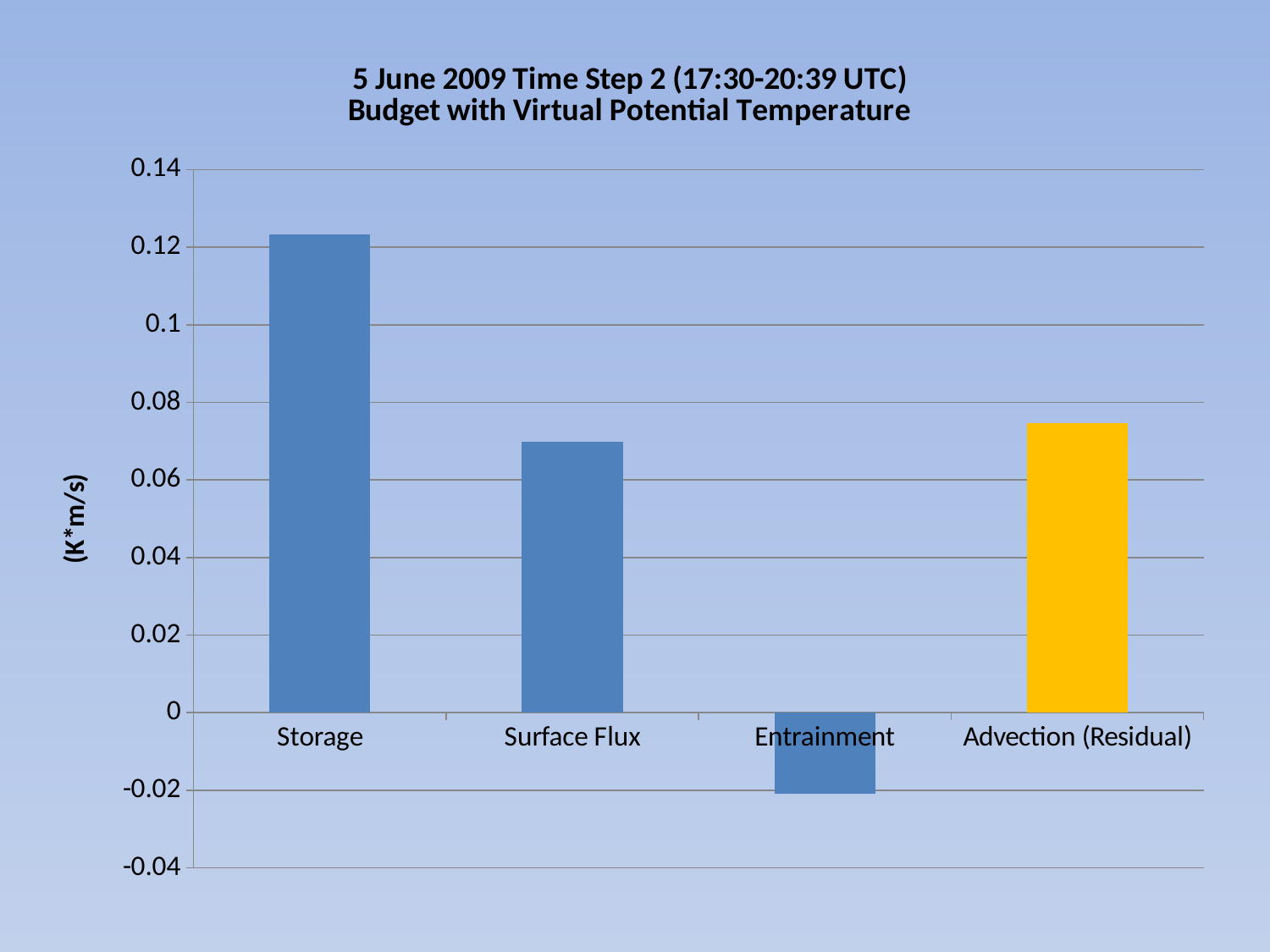
What colour is the bar for Advection (Residual)? yellow Is the value for Advection (Residual) greater or less than 0.08? less Is the value for Storage greater or less than 0.1? greater Which is larger, the value for Surface Flux or the value for Entrainment? Surface Flux What kind of chart is shown on the slide? bar chart What unit is shown on the y-axis label? (K*m/s) Which category has the highest value? Storage Which is larger, the value for Storage or the value for Surface Flux? Storage Which category has the lowest value? Entrainment Is the value for Surface Flux greater or less than 0.08? less How many categories are plotted on the chart? 4